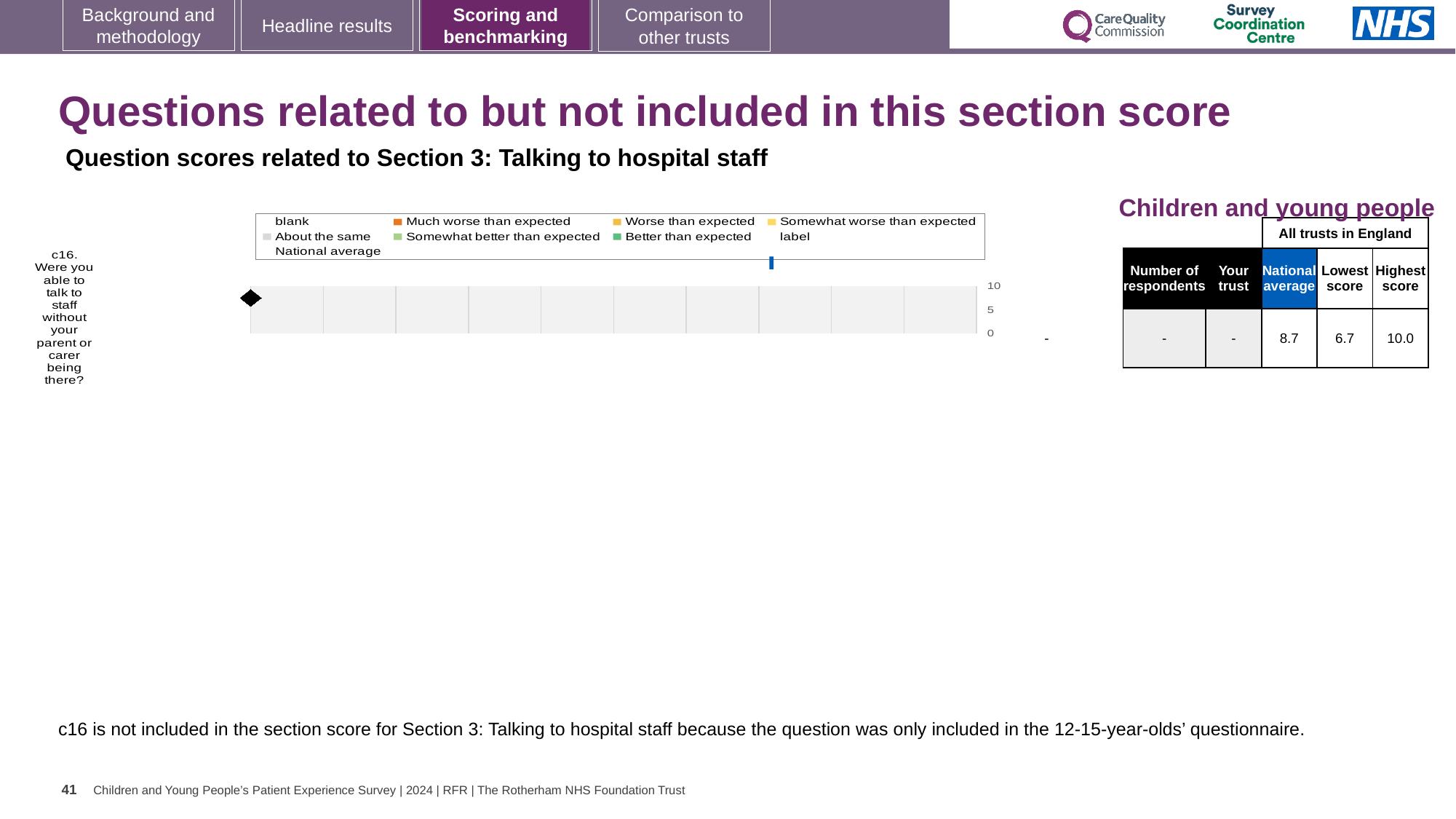
Is the national average score of 8.7 greater or less than 5? greater How many survey questions are plotted on the chart? 1 Which survey question is plotted on the chart? c16. Were you able to talk to staff without your parent or carer being there? In the table, what is the national average score for c16? 8.7 Which is larger in the table: the national average or the lowest score? National average What is shown in the table for the 'Your trust' score for c16? - In the table, what is the lowest score among all trusts in England for c16? 6.7 What is the difference between the highest score and the lowest score in the table? 3.3 In the table, what is the highest score among all trusts in England for c16? 10.0 What is the highest value shown on the chart's vertical axis? 10 What kind of chart is shown on the slide? bar chart